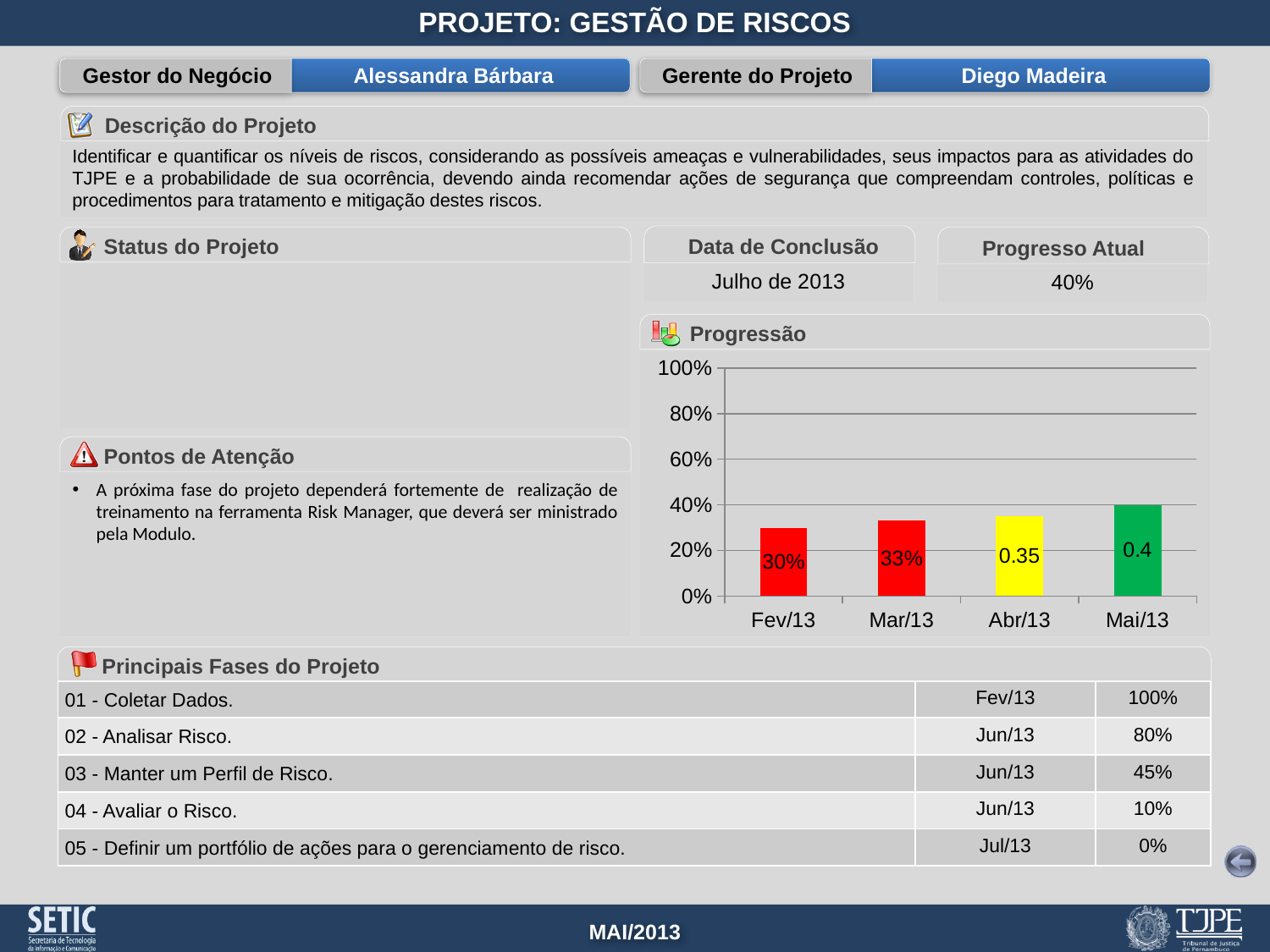
Do the values in the Progressão chart rise or fall from Fev/13 to Mai/13? rise What is the difference between the Mar/13 and Fev/13 values in the Progressão chart? 3% Which month has the highest bar in the Progressão chart? Mai/13 What kind of chart is the Progressão chart? bar chart What data label is printed on the Abr/13 bar in the Progressão chart? 0.35 Which is larger in the Progressão chart, the value for Abr/13 or the value for Mar/13? Abr/13 What data label is printed on the Mai/13 bar in the Progressão chart? 0.4 What is the value shown for Mar/13 in the Progressão chart? 33% What is the value shown for Fev/13 in the Progressão chart? 30% Which month has the lowest bar in the Progressão chart? Fev/13 How many months are plotted in the Progressão chart? 4 Is the value for Mai/13 in the Progressão chart greater or less than 60%? less